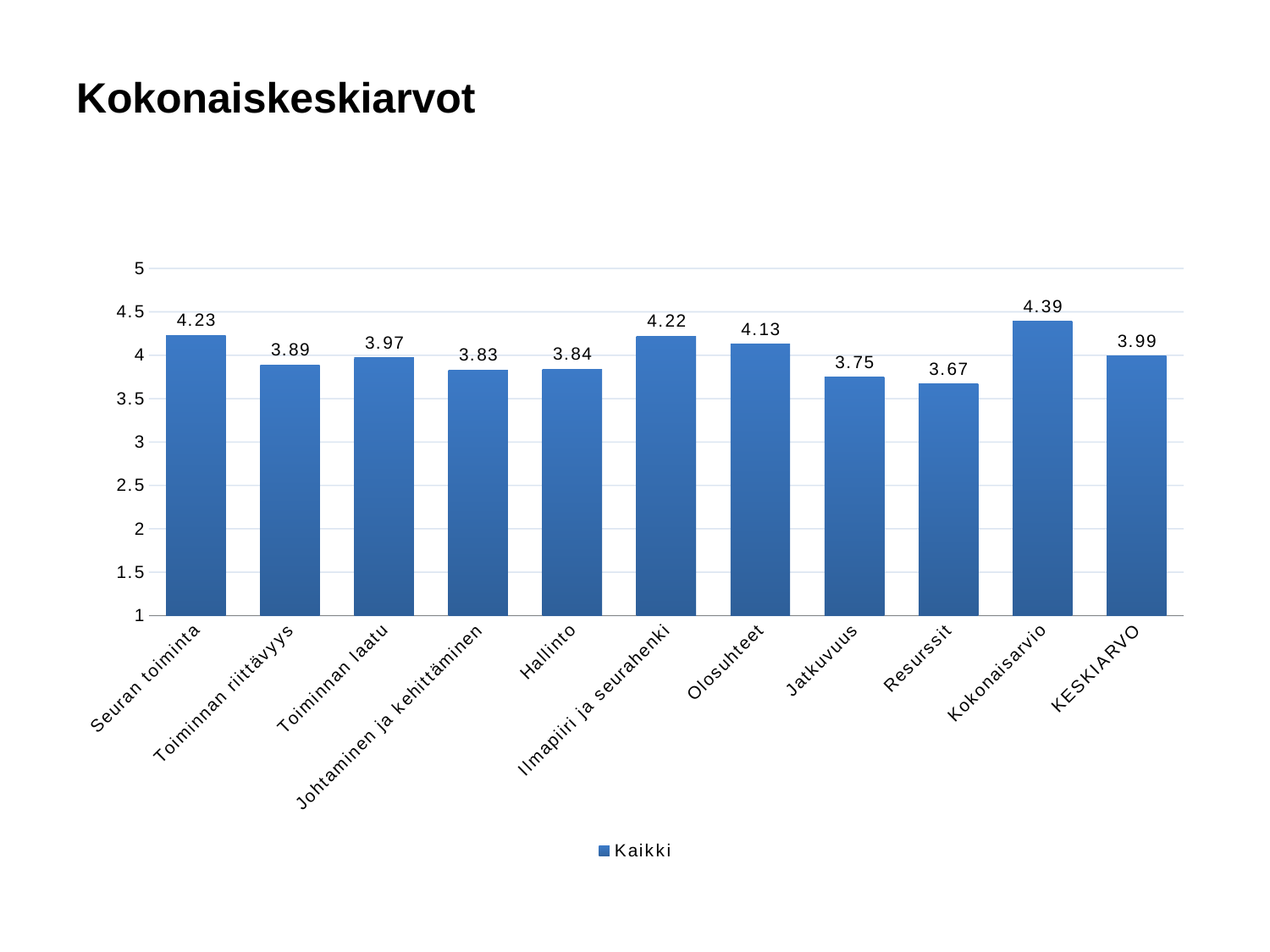
What is the value for Resurssit? 3.67 What is the value for Seuran toiminta? 4.23 Is the value for Hallinto greater or less than 4? less What is the difference between the values for Kokonaisarvio and Resurssit? 0.72 Which is larger, the value for Olosuhteet or the value for Jatkuvuus? Olosuhteet What is the title of the slide? Kokonaiskeskiarvot How many categories are shown on the x axis? 11 What is the value for KESKIARVO? 3.99 How many series does the legend list? 1 Which category has the highest value? Kokonaisarvio Which category has the lowest value? Resurssit What kind of chart is shown on the slide? bar chart